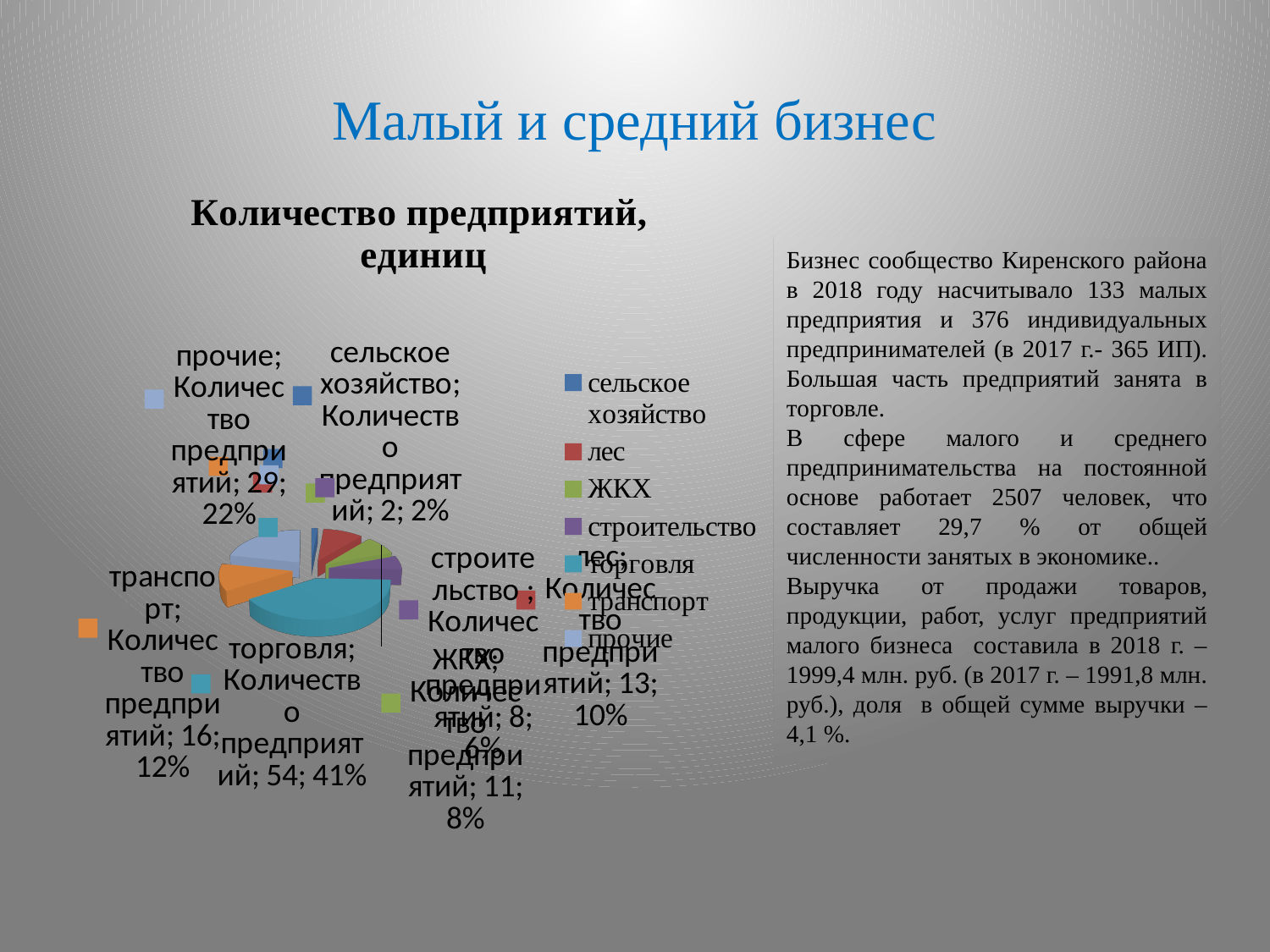
What is the difference between the number of enterprises in торговля and in прочие? 25 What share of the pie does транспорт take? 12% What share of the pie does торговля take? 41% How many categories does the legend of the pie chart list? 7 Which category has the largest slice of the pie? торговля What is the title of the chart? Количество предприятий, единиц How many enterprises are in the торговля category? 54 Which has more enterprises, лес or строительство? лес What kind of chart is shown on the slide? pie chart Which category has the smallest slice of the pie? сельское хозяйство How many enterprises are in the прочие category? 29 What share of the pie does ЖКХ take? 8%